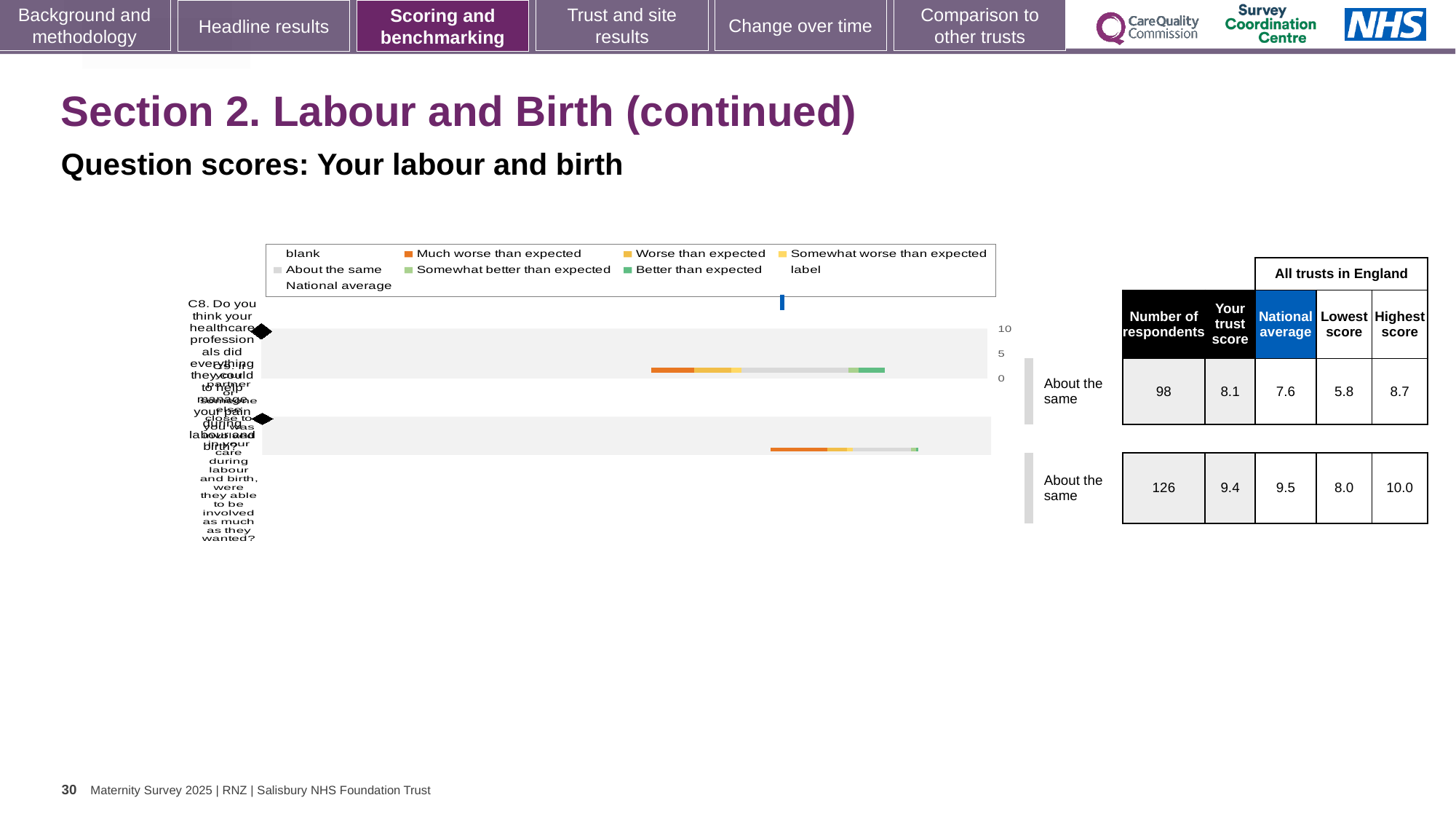
In the table, what is the highest score among all trusts in England for the second question row? 10.0 What is the difference between the trust score and the national average for the first question row? 0.5 For the second question row, which is larger: the trust score or the national average? National average Which legend entry is shown in orange? Much worse than expected In the table, what is the lowest score among all trusts in England for the second question row? 8.0 What benchmark category is shown for both question rows? About the same In the table, what is the number of respondents for the first question row? 98 What is the difference between the highest and lowest scores for the first question row? 2.9 In the table, what is the national average for the first question row? 7.6 How many question rows (bars) are plotted in the chart? 2 What kind of chart is shown on the slide? bar chart In the table, what is the trust score for the first question row? 8.1